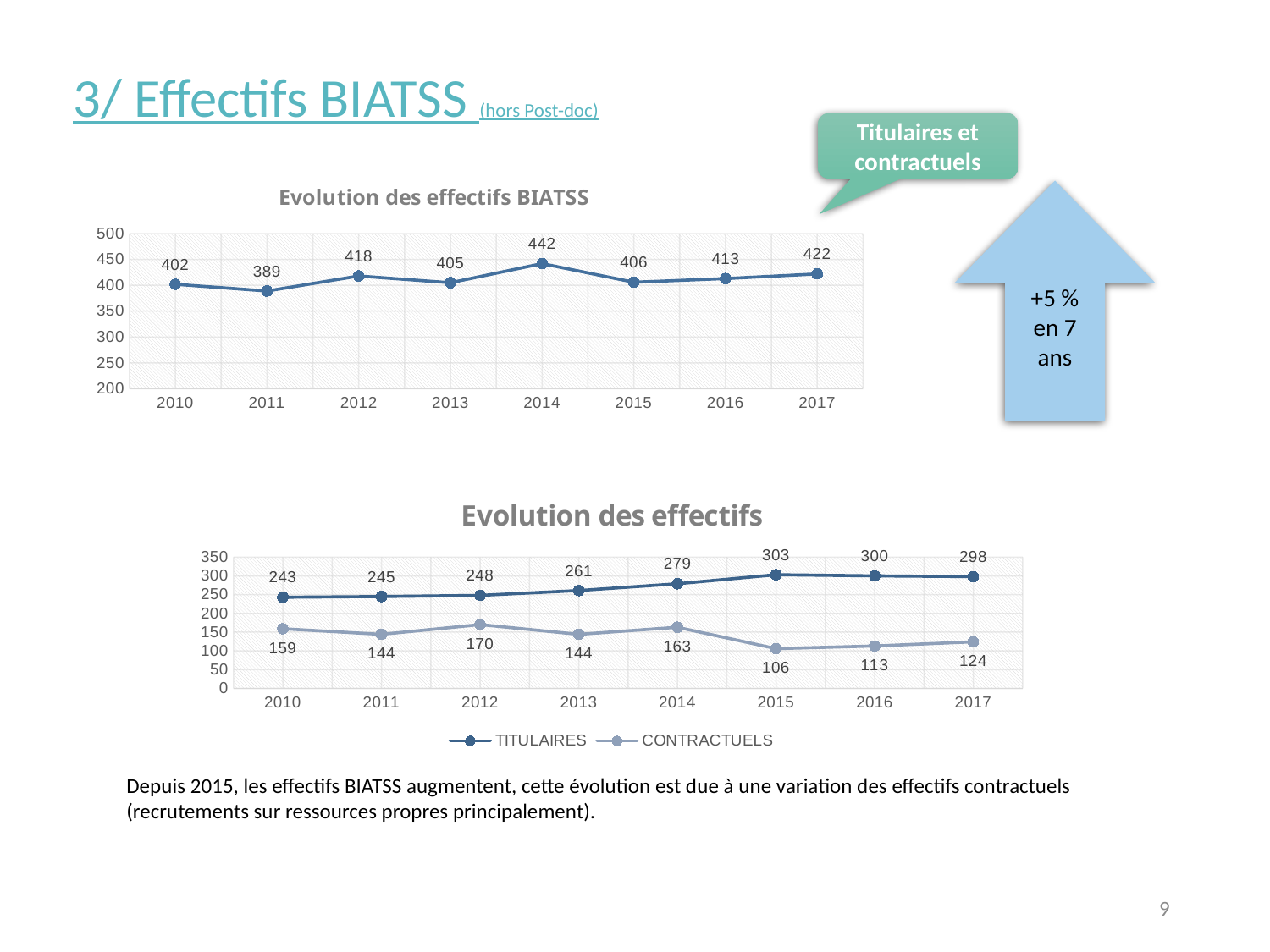
In the chart 'Evolution des effectifs BIATSS', what is the difference between the 2017 value and the 2010 value? 20 In the chart 'Evolution des effectifs', which year has the highest TITULAIRES value? 2015 In the chart 'Evolution des effectifs', does the TITULAIRES series rise or fall from 2010 to 2015? Rise In the chart 'Evolution des effectifs', what is the value for TITULAIRES in 2013? 261 In the chart 'Evolution des effectifs', what is the difference between TITULAIRES and CONTRACTUELS in 2017? 174 In the chart 'Evolution des effectifs BIATSS', what is the value for 2014? 442 In the chart 'Evolution des effectifs BIATSS', how many years are plotted? 8 In the chart 'Evolution des effectifs BIATSS', which year has the lowest value? 2011 How many series does the legend of the chart 'Evolution des effectifs' list? 2 In the chart 'Evolution des effectifs', which is larger: CONTRACTUELS in 2012 or CONTRACTUELS in 2014? 2012 What kind of chart is 'Evolution des effectifs BIATSS'? Line chart In the chart 'Evolution des effectifs', what is the value for CONTRACTUELS in 2015? 106